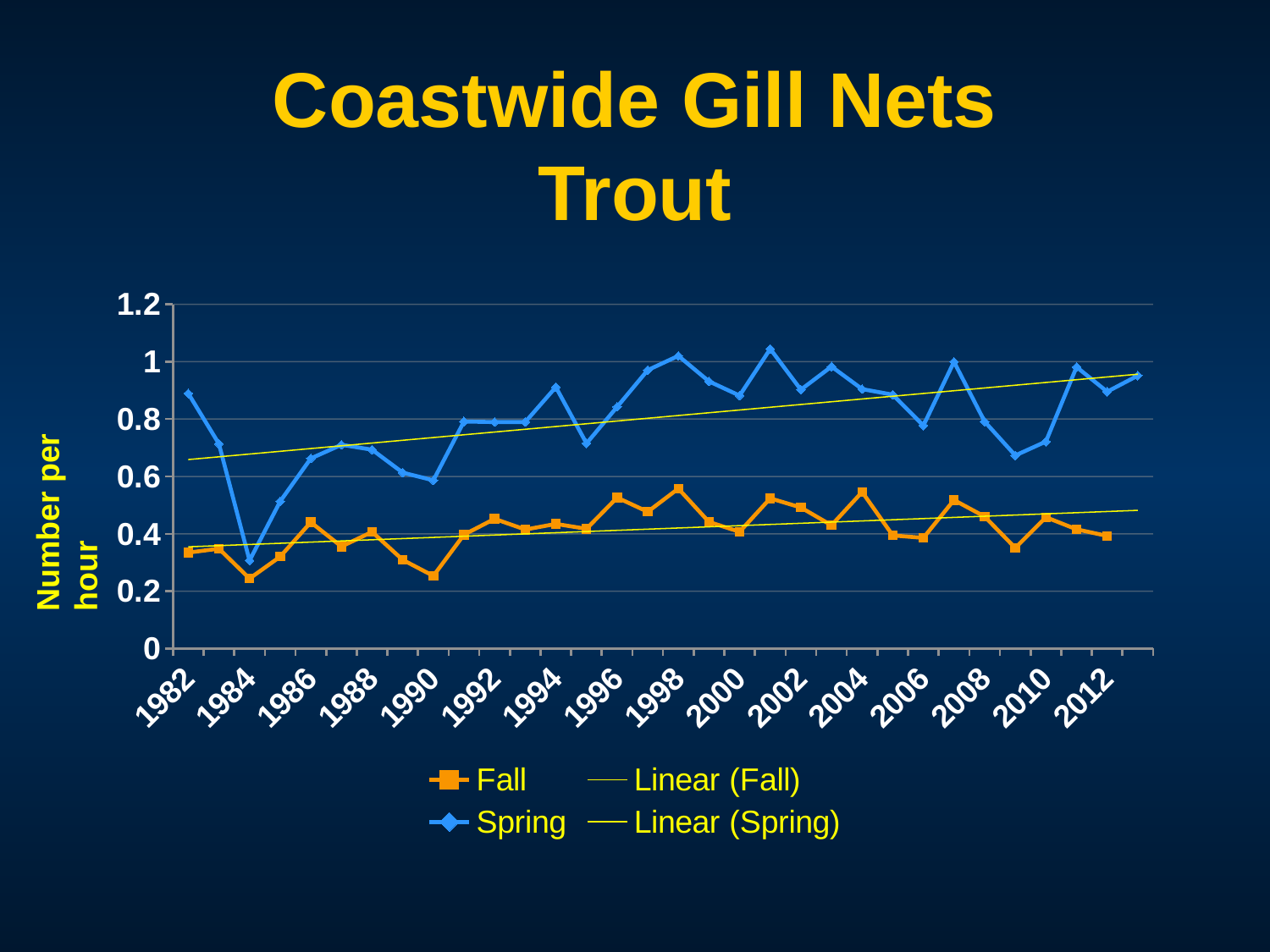
In 1982, which series has the higher value, Fall or Spring? Spring What is the label on the vertical axis? Number per hour In which year is the Spring series at its lowest? 1984 What kind of chart is shown on the slide? line chart Is the Spring value for 2001 greater or less than 1? greater Is the Spring value for 1984 greater or less than 0.6? less Is the Fall value for 1998 greater or less than 0.4? greater What is the title of the chart? Coastwide Gill Nets Trout How many entries does the legend list? 4 Does the Linear (Spring) trendline rise or fall from left to right? rise